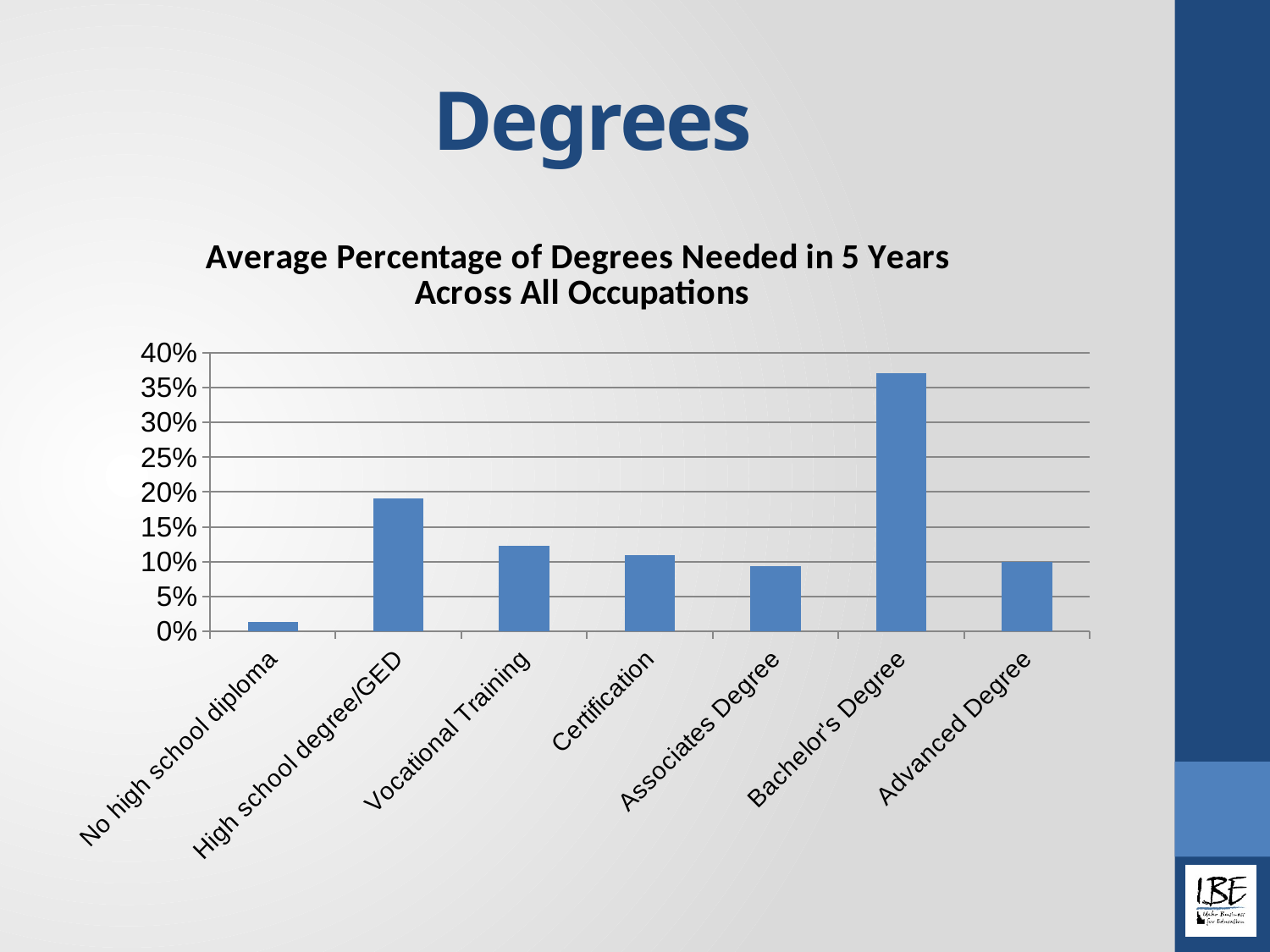
Is the value for High school degree/GED greater or less than 15%? greater How many degree categories are shown on the x axis? 7 Is the value for Advanced Degree greater or less than 15%? less Is the value for No high school diploma greater or less than 5%? less Which is larger, the value for Bachelor's Degree or the value for High school degree/GED? Bachelor's Degree Which category has the highest value? Bachelor's Degree Which is larger, the value for High school degree/GED or the value for Vocational Training? High school degree/GED What is the title of the chart? Average Percentage of Degrees Needed in 5 Years Across All Occupations What kind of chart is shown on the slide? bar chart Which category has the lowest value? No high school diploma